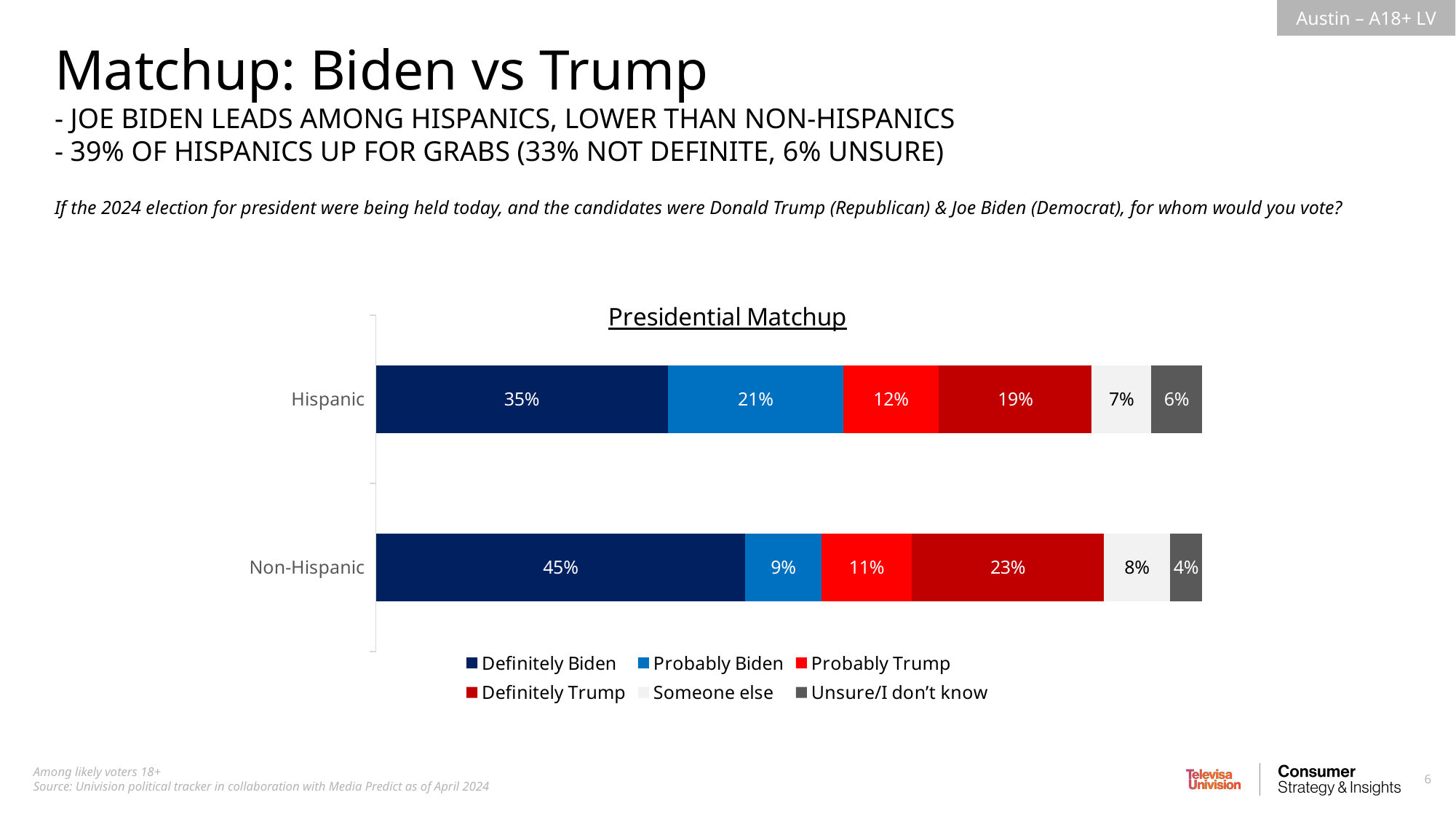
What is the Probably Biden value for Non-Hispanic? 9% What kind of chart is shown on the slide? Stacked bar chart What is the difference between the Definitely Trump values for Non-Hispanic and Hispanic? 4% What is the Definitely Biden value for Hispanic? 35% What is the title of the chart? Presidential Matchup What is the Definitely Trump value for Hispanic? 19% What is the total of the stacked bar for Hispanic? 100% How many series does the legend list? 6 How many categories are plotted on the chart? 2 Which category has the higher Definitely Biden value, Hispanic or Non-Hispanic? Non-Hispanic Which series is the largest segment in the Non-Hispanic bar? Definitely Biden What is the Unsure/I don't know value for Non-Hispanic? 4%